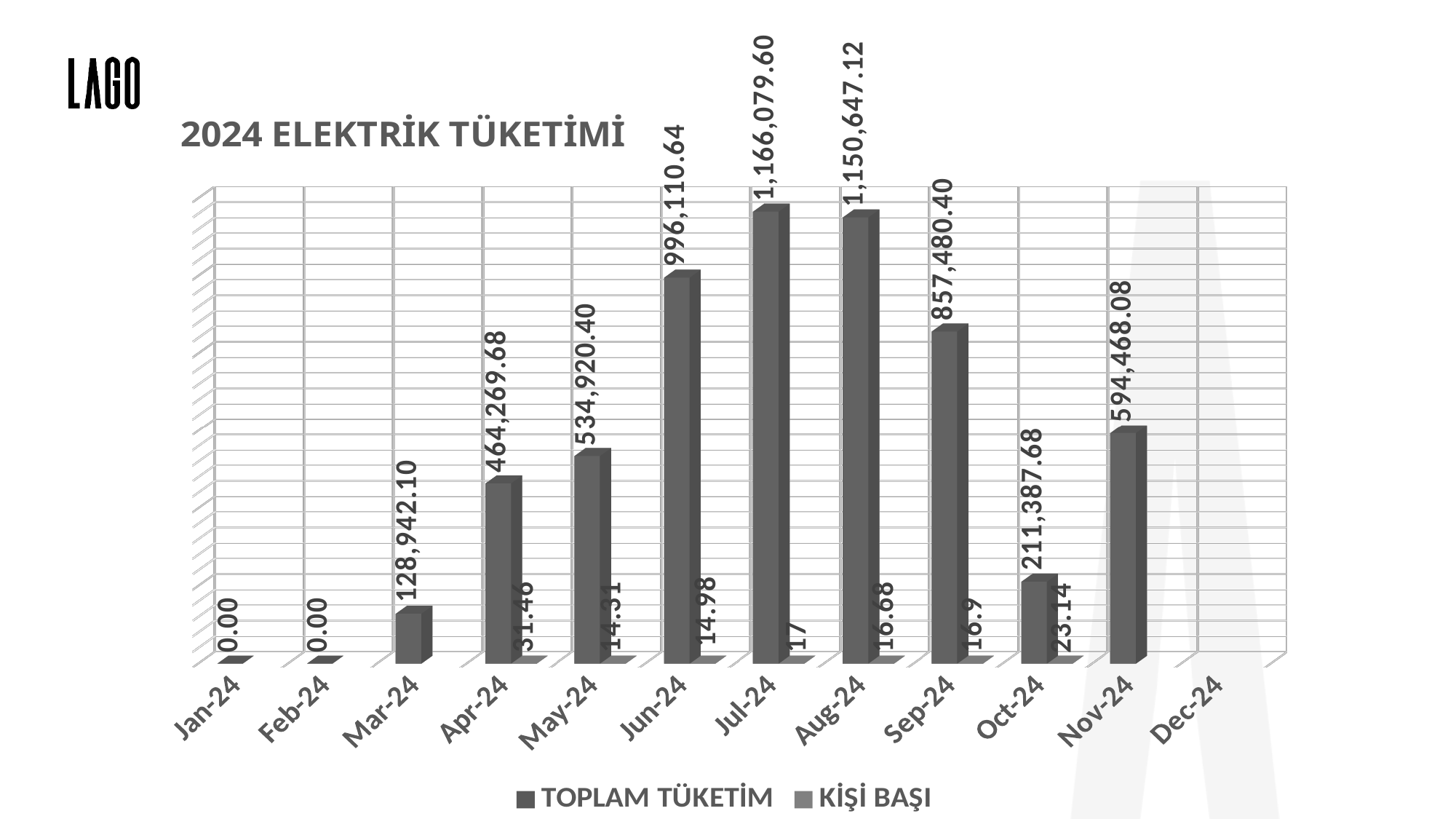
Which has the larger TOPLAM TÜKETİM value, Nov-24 or May-24? Nov-24 Which month has the highest TOPLAM TÜKETİM value? Jul-24 What is the KİŞİ BAŞI value for Oct-24? 23.14 What is the TOPLAM TÜKETİM value for Nov-24? 594,468.08 What is the TOPLAM TÜKETİM value for Jul-24? 1,166,079.60 What is the difference between the TOPLAM TÜKETİM values for Jun-24 and May-24? 461,190.24 How many months are shown on the x axis? 12 What is the difference between the TOPLAM TÜKETİM values for Jul-24 and Aug-24? 15,432.48 What kind of chart is shown on the slide? Bar chart Which month has the lowest non-zero TOPLAM TÜKETİM value? Mar-24 How many series does the legend list? 2 What is the TOPLAM TÜKETİM value for Mar-24? 128,942.10